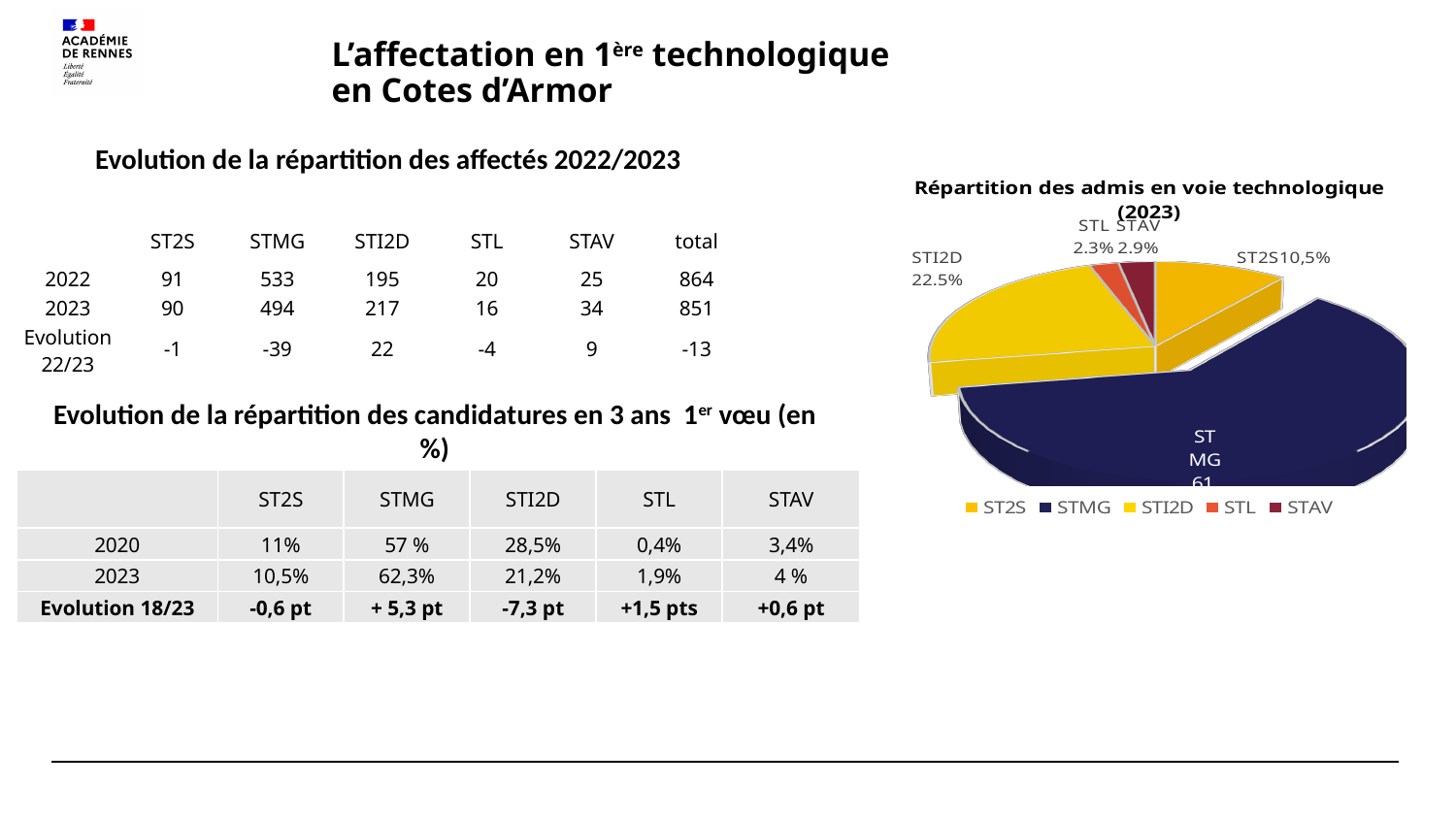
What is the title of the pie chart? Répartition des admis en voie technologique (2023) In the pie chart, which is larger, the STI2D slice or the ST2S slice? STI2D What kind of chart is shown on the slide? pie chart What share of the pie chart does STI2D represent? 22.5% How many slices does the pie chart have? 5 What share of the pie chart does STL represent? 2.3% What share of the pie chart does STAV represent? 2.9% Which category has the largest slice in the pie chart? STMG Which category has the smallest slice in the pie chart? STL What share of the pie chart does ST2S represent? 10,5% How many entries does the legend of the pie chart list? 5 In the pie chart, what is the difference between the STAV share and the STL share? 0.6%